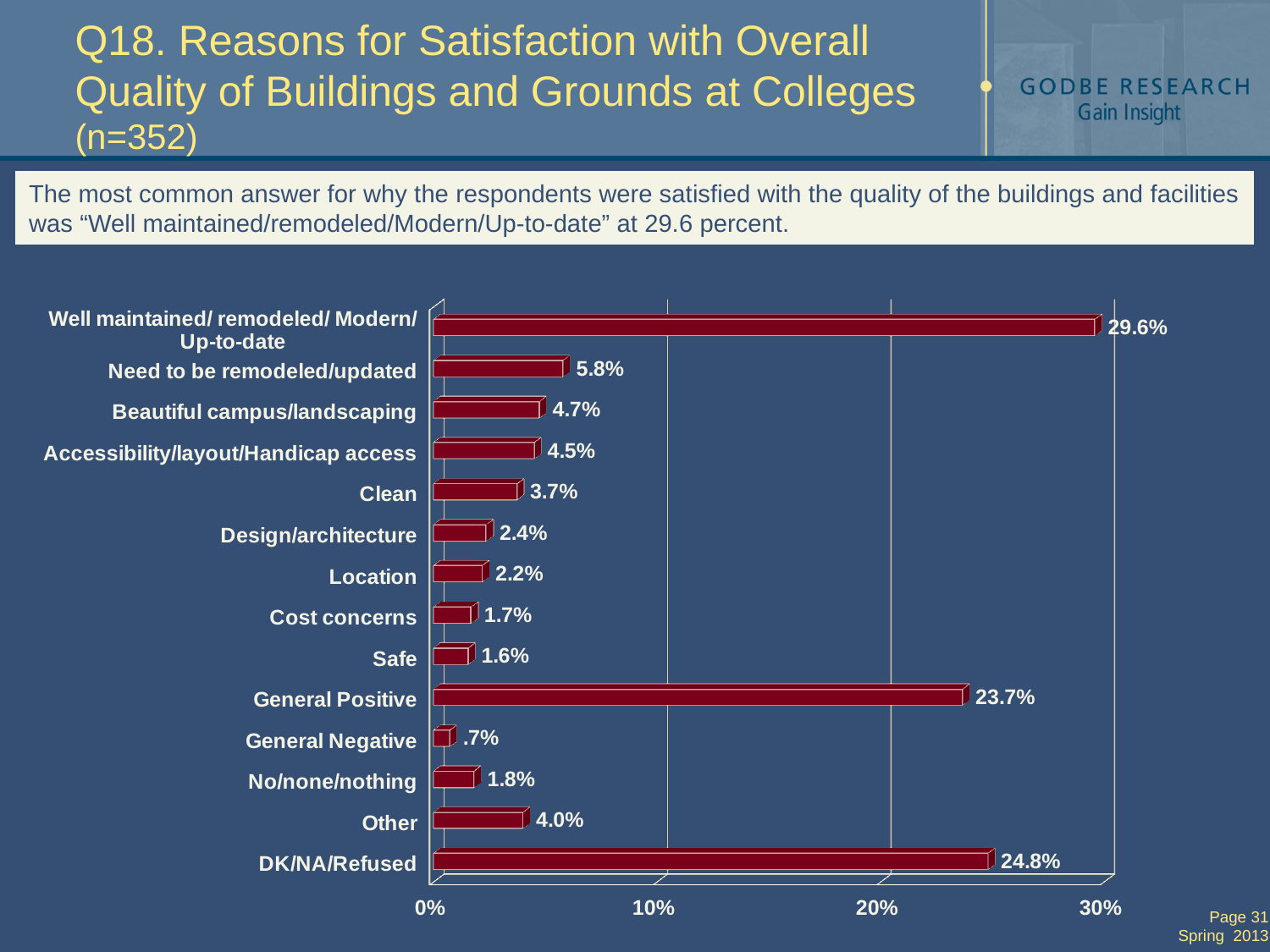
What is the value for "General Positive"? 23.7% Is the value for "DK/NA/Refused" greater or less than 20%? greater Which is larger, the value for "Need to be remodeled/updated" or the value for "Other"? Need to be remodeled/updated What is the value for "Beautiful campus/landscaping"? 4.7% What is the value for "DK/NA/Refused"? 24.8% What kind of chart is shown on the slide? bar chart What is the value for "Clean"? 3.7% Which category has the lowest value? General Negative What is the sample size (n) stated in the chart title? 352 How many categories are shown in the chart? 14 Which category has the highest value? Well maintained/ remodeled/ Modern/ Up-to-date What is the difference between the values for "Well maintained/ remodeled/ Modern/ Up-to-date" and "General Positive"? 5.9%